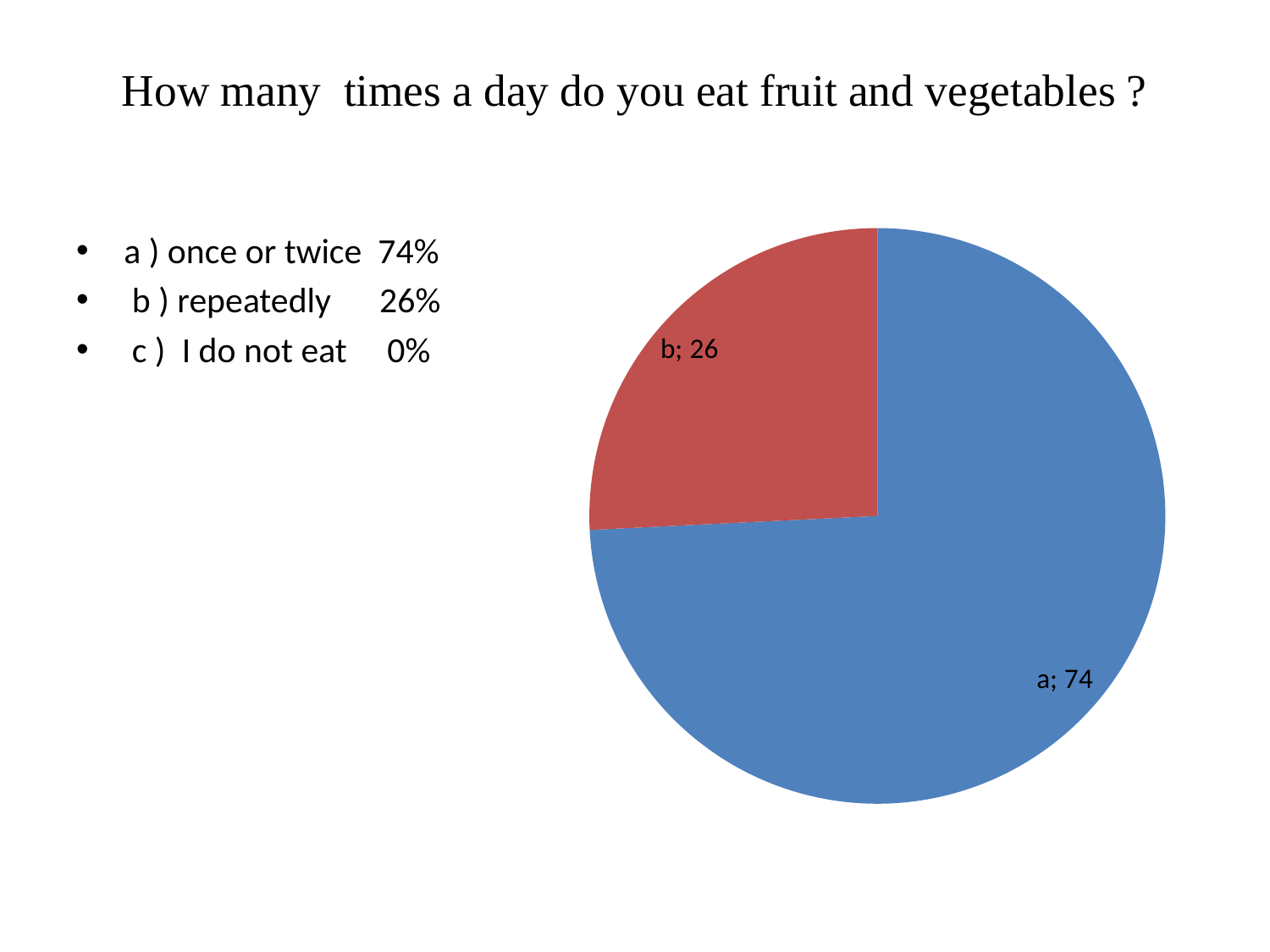
What share of the pie does slice a represent? 74% What colour is the slice for a? blue What kind of chart is shown on the slide? pie chart Which slice is the largest in the pie chart? a What is the total of the two labelled slice values? 100 Which slice is the smallest in the pie chart? b What is the difference between the values for a and b? 48 How many slices are shown in the pie chart? 2 Which is larger, the value for a or the value for b? a What colour is the slice for b? red What value is labelled on the slice for b? 26 What value is labelled on the slice for a? 74